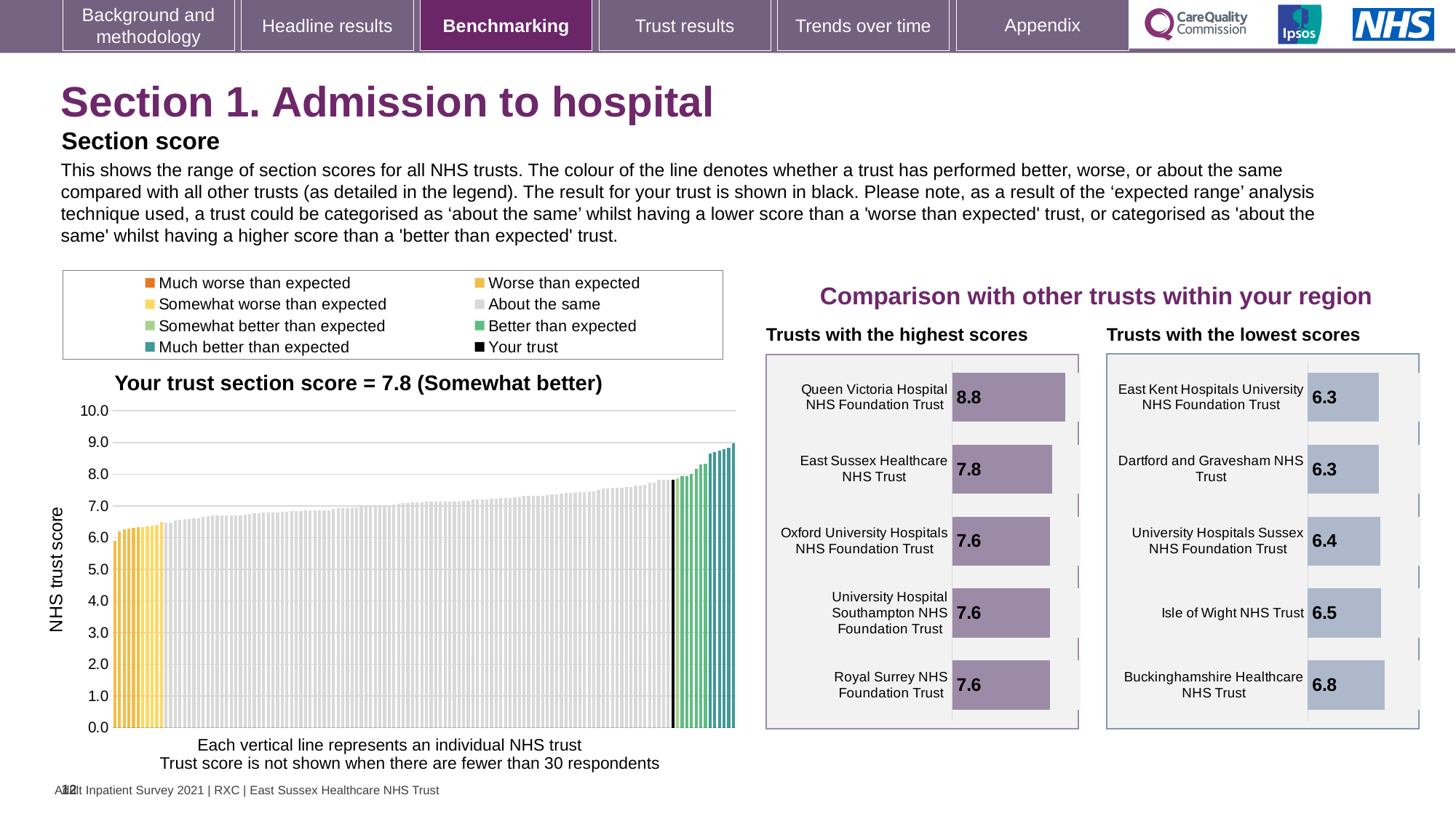
How many trusts are shown in the 'Trusts with the highest scores' chart? 5 In the chart titled 'Your trust section score', what is the section score for your trust? 7.8 In the 'Trusts with the lowest scores' chart, which has the larger score: University Hospitals Sussex NHS Foundation Trust or Buckinghamshire Healthcare NHS Trust? Buckinghamshire Healthcare NHS Trust In the 'Trusts with the lowest scores' chart, which trust has the highest score? Buckinghamshire Healthcare NHS Trust How many entries does the legend above the 'Your trust section score' chart list? 8 In the 'Trusts with the lowest scores' chart, what is the score for Isle of Wight NHS Trust? 6.5 In the 'Trusts with the highest scores' chart, what is the score for Queen Victoria Hospital NHS Foundation Trust? 8.8 In the 'Your trust section score' chart, what is the label of the y axis? NHS trust score In the 'Trusts with the highest scores' chart, which trust has the highest score? Queen Victoria Hospital NHS Foundation Trust What kind of chart is the 'Your trust section score' chart? bar chart In the 'Your trust section score' chart, do the bar heights rise or fall from left to right along the x axis? rise In the 'Trusts with the highest scores' chart, what is the difference between the scores of Queen Victoria Hospital NHS Foundation Trust and East Sussex Healthcare NHS Trust? 1.0